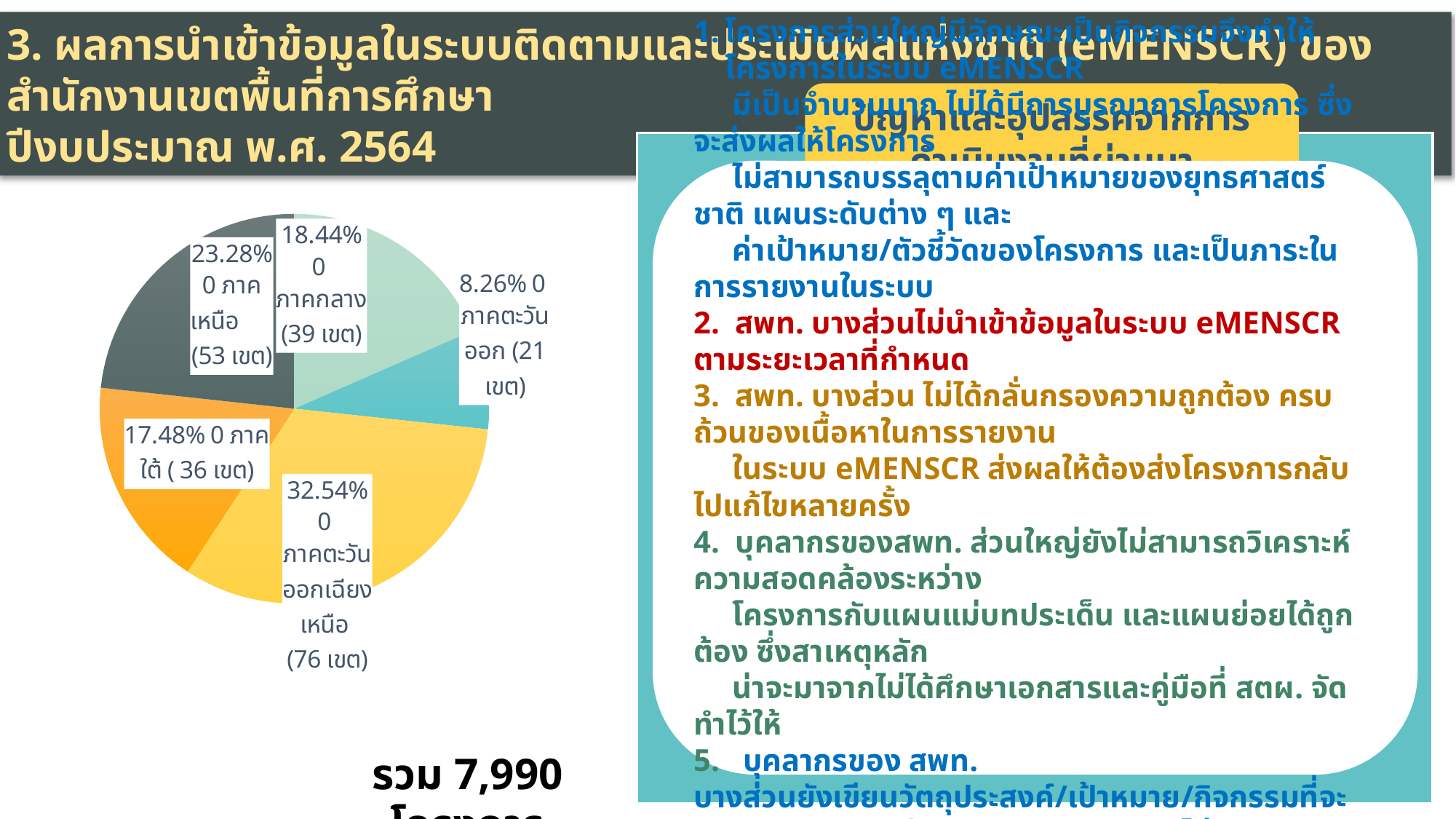
What is the difference in percentage points between ภาคตะวันออกเฉียงเหนือ and ภาคกลาง in the pie chart? 14.10 What kind of chart is shown on the left of the slide? pie chart Which has a larger share in the pie chart, ภาคเหนือ or ภาคใต้? ภาคเหนือ What percentage does the pie chart show for ภาคเหนือ? 23.28% How many slices does the pie chart have? 5 Which region has the largest share in the pie chart? ภาคตะวันออกเฉียงเหนือ What percentage does the pie chart show for ภาคตะวันออก? 8.26% Which region has the smallest share in the pie chart? ภาคตะวันออก How many เขต are listed for ภาคใต้ in the pie chart label? 36 เขต How many เขต are listed for ภาคกลาง in the pie chart label? 39 เขต What percentage does the pie chart show for ภาคตะวันออกเฉียงเหนือ? 32.54% What total number of projects (โครงการ) is stated below the pie chart? 7,990